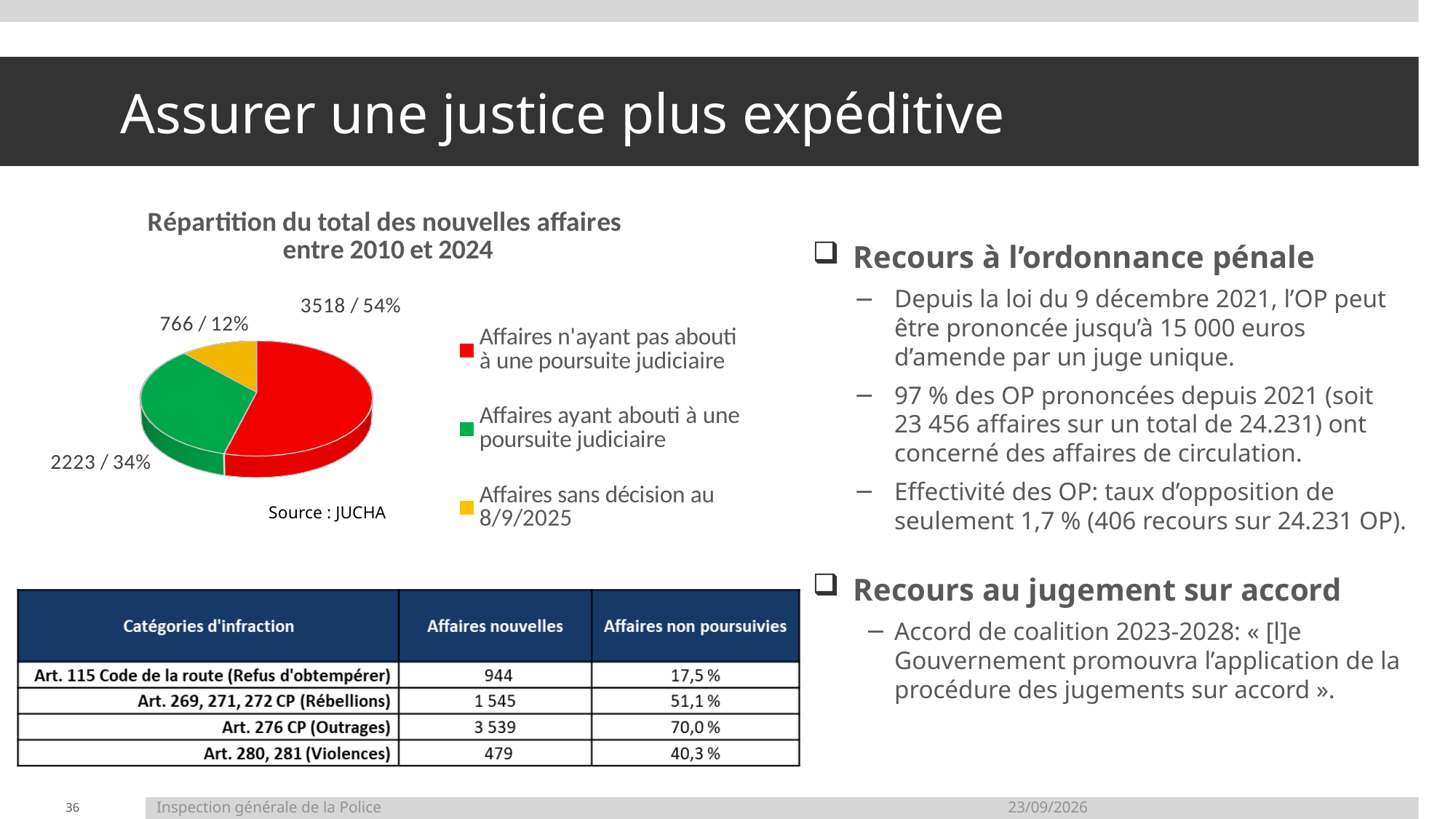
Which colour represents 'Affaires sans décision au 8/9/2025' in the pie chart? yellow What kind of chart is shown on the slide? pie chart Which category has the largest slice in the pie chart? Affaires n'ayant pas abouti à une poursuite judiciaire What value is shown for 'Affaires n'ayant pas abouti à une poursuite judiciaire' in the pie chart? 3518 / 54% What value is shown for 'Affaires sans décision au 8/9/2025' in the pie chart? 766 / 12% What value is shown for 'Affaires ayant abouti à une poursuite judiciaire' in the pie chart? 2223 / 34% Which category has the smallest slice in the pie chart? Affaires sans décision au 8/9/2025 How many entries does the pie chart's legend list? 3 What is the difference in number of cases between 'Affaires n'ayant pas abouti à une poursuite judiciaire' and 'Affaires ayant abouti à une poursuite judiciaire'? 1295 What is the title of the pie chart? Répartition du total des nouvelles affaires entre 2010 et 2024 What share of the pie does 'Affaires ayant abouti à une poursuite judiciaire' represent? 34% How many slices does the pie chart have? 3